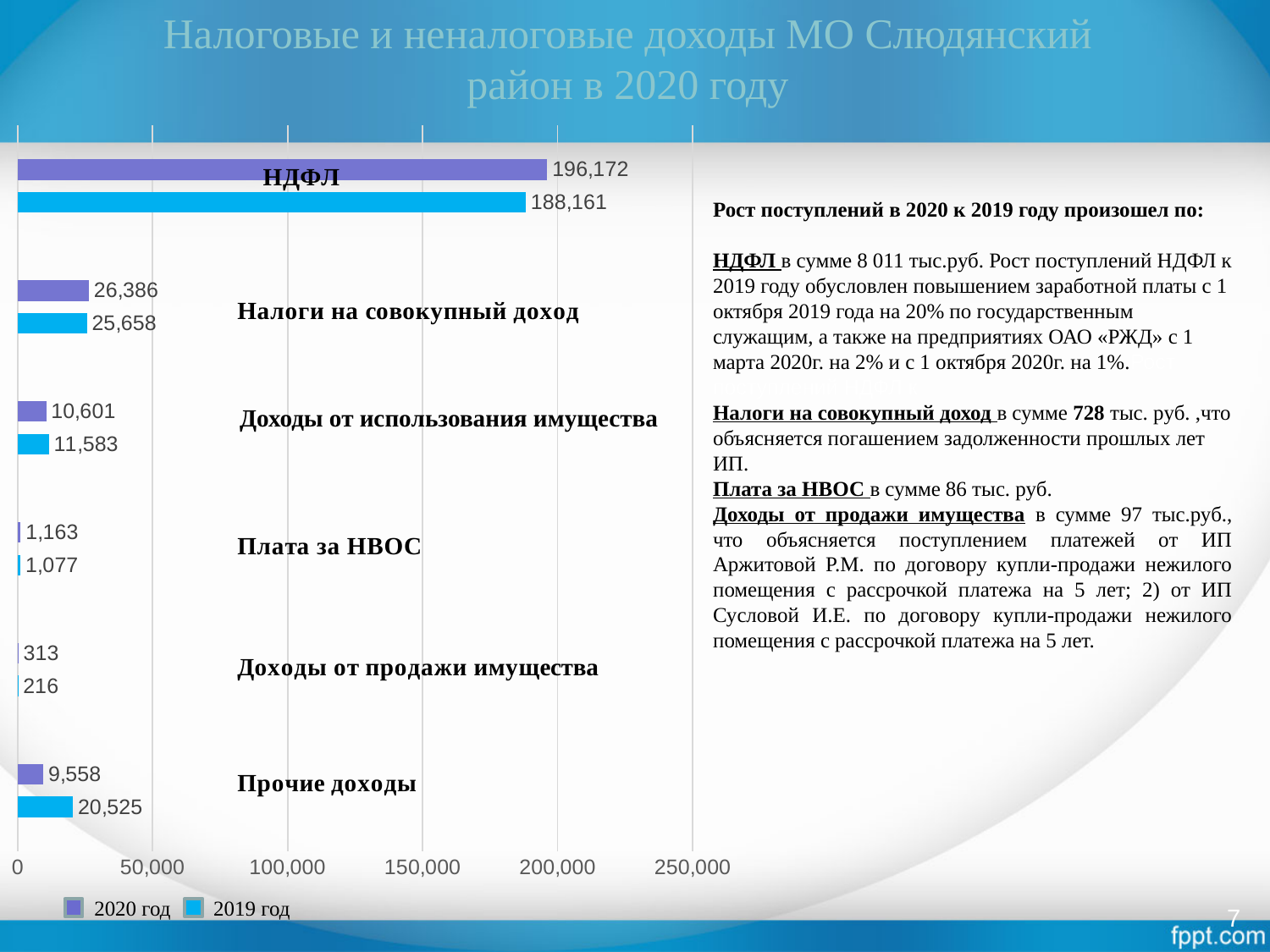
What is the value for Доходы от использования имущества in the 2020 год series? 10,601 How many series does the legend list? 2 What is the value for Прочие доходы in the 2019 год series? 20,525 What is the difference between the 2019 год and 2020 год values for Прочие доходы? 10,967 What kind of chart is shown on the slide? bar chart Which category has the highest value in the 2020 год series? НДФЛ How many categories are shown on the chart? 6 Is the 2019 год value for НДФЛ greater or less than 150,000? greater What is the value for НДФЛ in the 2020 год series? 196,172 What is the difference between the 2020 год and 2019 год values for НДФЛ? 8,011 Which category has the lowest value in the 2019 год series? Доходы от продажи имущества For Доходы от использования имущества, which series has the larger value, 2020 год or 2019 год? 2019 год